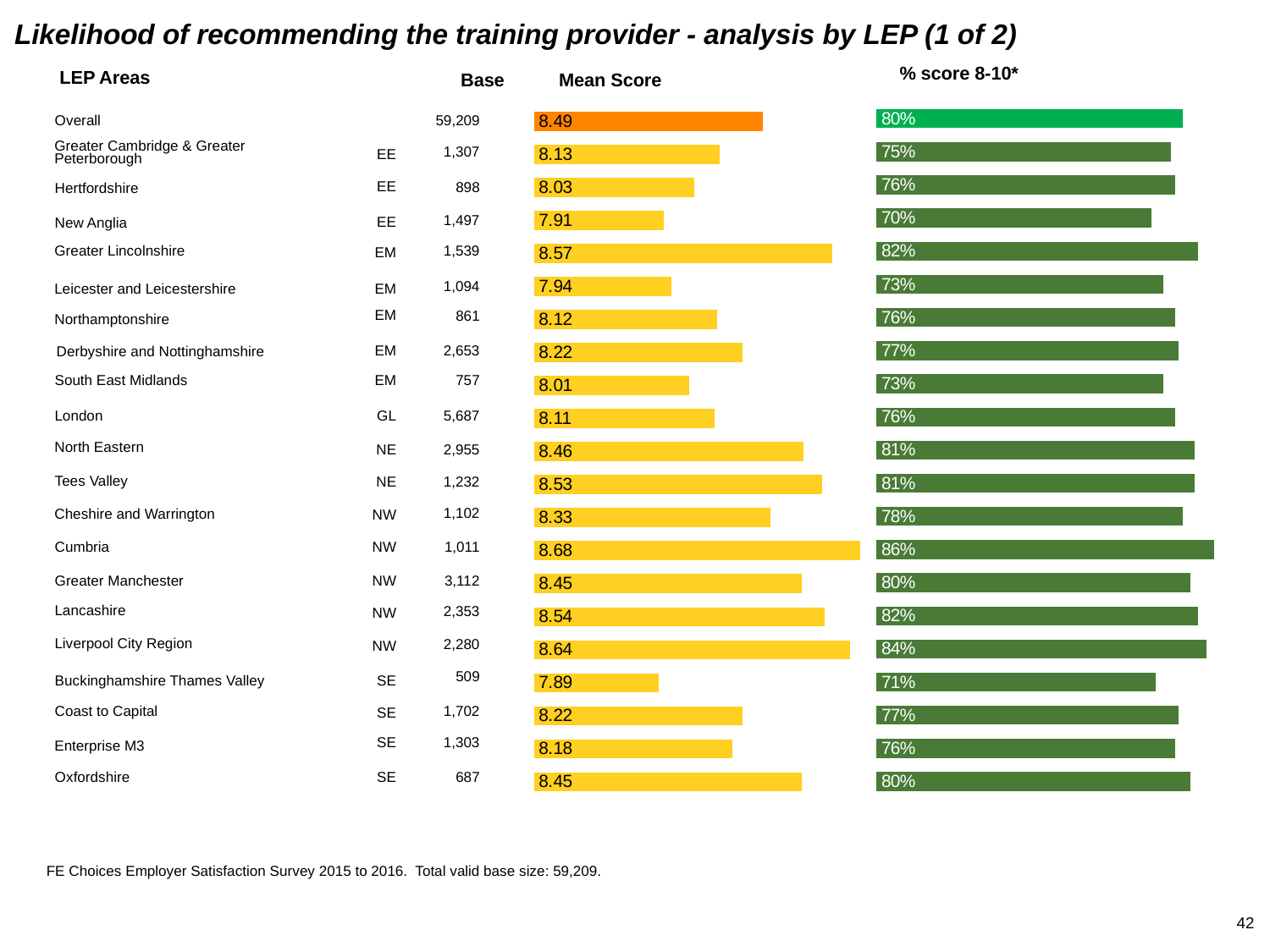
In the Mean Score chart, what is the mean score for Cumbria? 8.68 In the % score 8-10* chart, what is the value for Liverpool City Region? 84% In the Mean Score chart, what is the difference between Greater Lincolnshire and Leicester and Leicestershire? 0.63 In the % score 8-10* chart, what is the value for New Anglia? 70% What type of chart is used for the % score 8-10* column? Bar chart In the Mean Score chart, which is larger, Tees Valley or North Eastern? Tees Valley In the Mean Score chart, what is the mean score for Overall? 8.49 In the % score 8-10* chart, what is the difference between Cumbria and New Anglia? 16% In the Mean Score chart, which LEP area has the highest mean score? Cumbria In the % score 8-10* chart, which LEP area has the lowest value? New Anglia How many LEP area bars (including Overall) are shown in the Mean Score chart? 21 In the Mean Score chart, which LEP area has the lowest mean score? Buckinghamshire Thames Valley